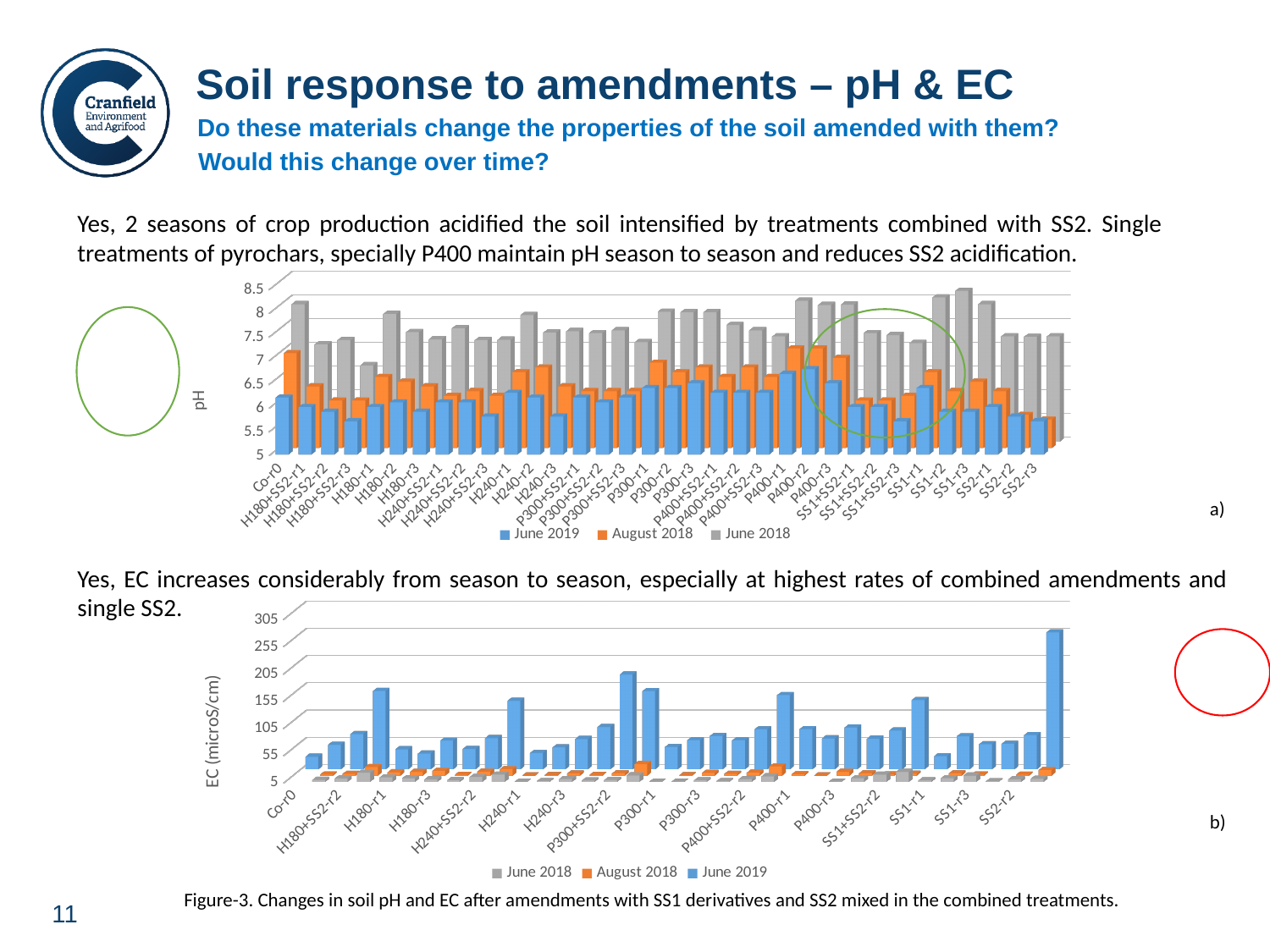
In the top pH chart, is the August 2018 value for Co-r0 greater or less than 6.5? greater In the bottom EC chart, is the June 2019 value for P300-r1 greater or less than 155? less In the bottom EC chart, is the June 2019 value for Co-r0 greater or less than 55? less What kind of chart is the bottom chart (b), showing EC? bar chart How many series does the legend of the top pH chart list? 3 What is the y-axis title of the bottom chart (b)? EC (microS/cm) What kind of chart is the top chart (a), showing pH? bar chart In the bottom EC chart, which series has the tallest bars overall? June 2019 What are the three series listed in the legend of the bottom EC chart? June 2018, August 2018, June 2019